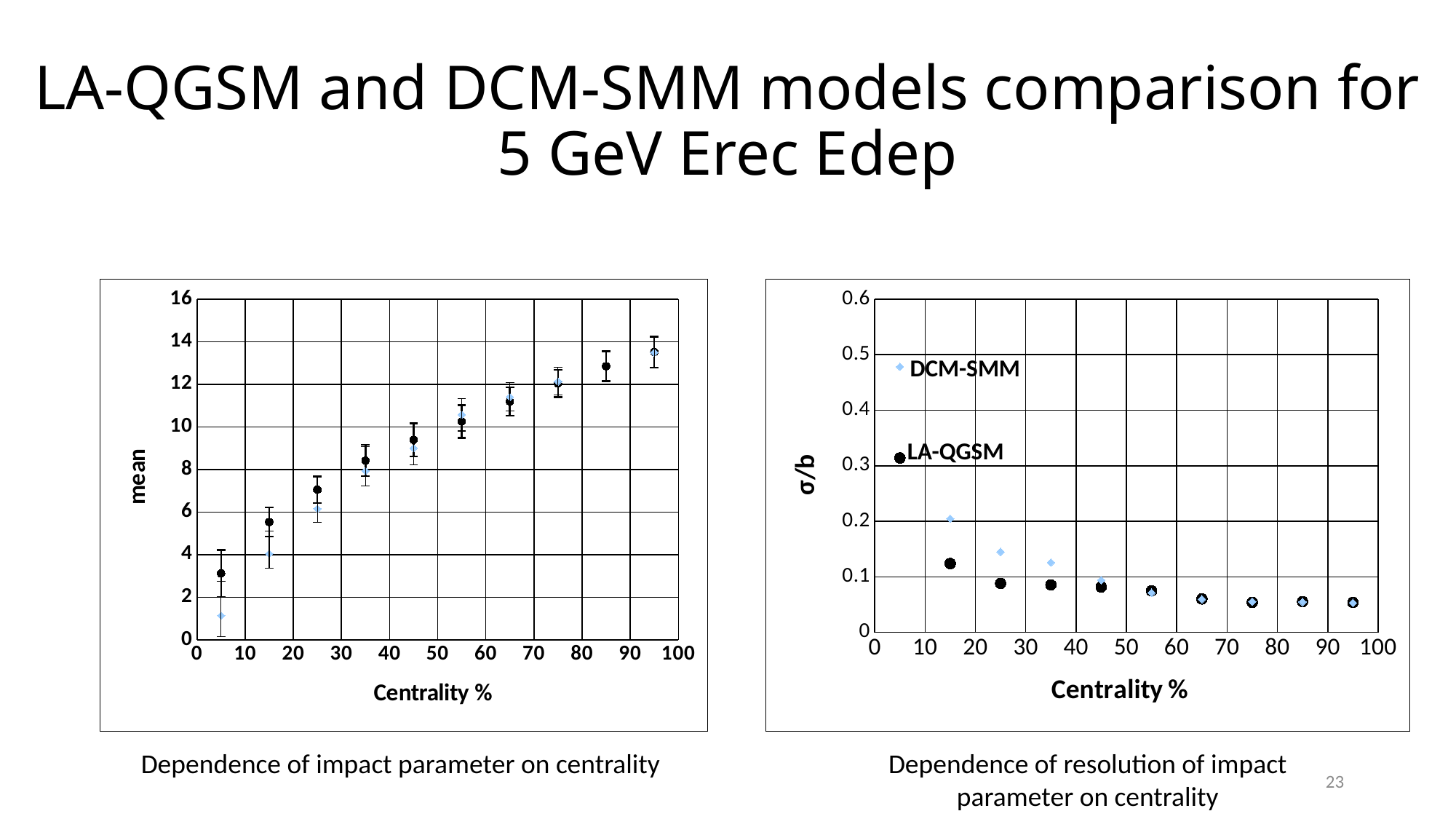
In the left chart, 'Dependence of impact parameter on centrality', is the LA-QGSM mean at centrality 95 greater or less than 12? greater In the right chart, 'Dependence of resolution of impact parameter on centrality', is the LA-QGSM σ/b at centrality 15 greater or less than 0.2? less What kind of chart is the left chart, 'Dependence of impact parameter on centrality'? scatter chart In the right chart, 'Dependence of resolution of impact parameter on centrality', does σ/b rise or fall as centrality increases? fall In the right chart, 'Dependence of resolution of impact parameter on centrality', is the DCM-SMM σ/b at centrality 5 greater or less than 0.4? greater In the right chart, 'Dependence of resolution of impact parameter on centrality', which series has the larger σ/b at centrality 15? DCM-SMM In the left chart, 'Dependence of impact parameter on centrality', do the mean values rise or fall as centrality increases? rise What is the x-axis label of the left chart, 'Dependence of impact parameter on centrality'? Centrality % In the right chart, 'Dependence of resolution of impact parameter on centrality', what are the two series named in the legend? DCM-SMM and LA-QGSM In the right chart, 'Dependence of resolution of impact parameter on centrality', how many series does the legend list? 2